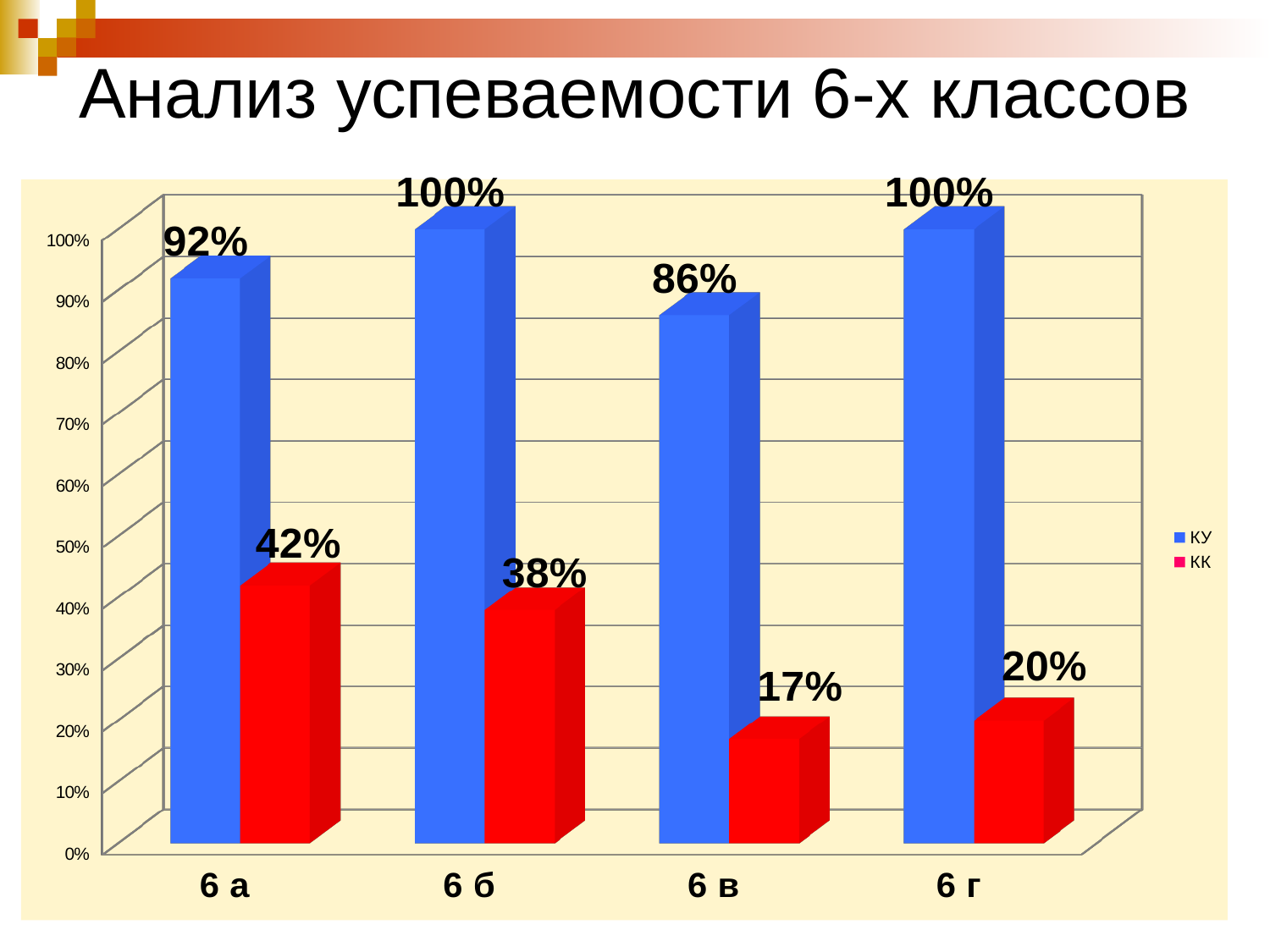
Which is larger, the КК value for 6 б or the КК value for 6 г? 6 б What is the КК value for class 6 г? 20% What colour are the КК bars? Red What is the КУ value for class 6 а? 92% Which class has the lowest КУ value? 6 в How many series does the legend list? 2 What is the difference between the КУ and КК values for class 6 в? 69% What is the КК value for class 6 в? 17% Which class has the highest КК value? 6 а What kind of chart is shown on the slide? Bar chart How many classes are shown on the x axis? 4 What is the difference between the КК values for 6 а and 6 б? 4%